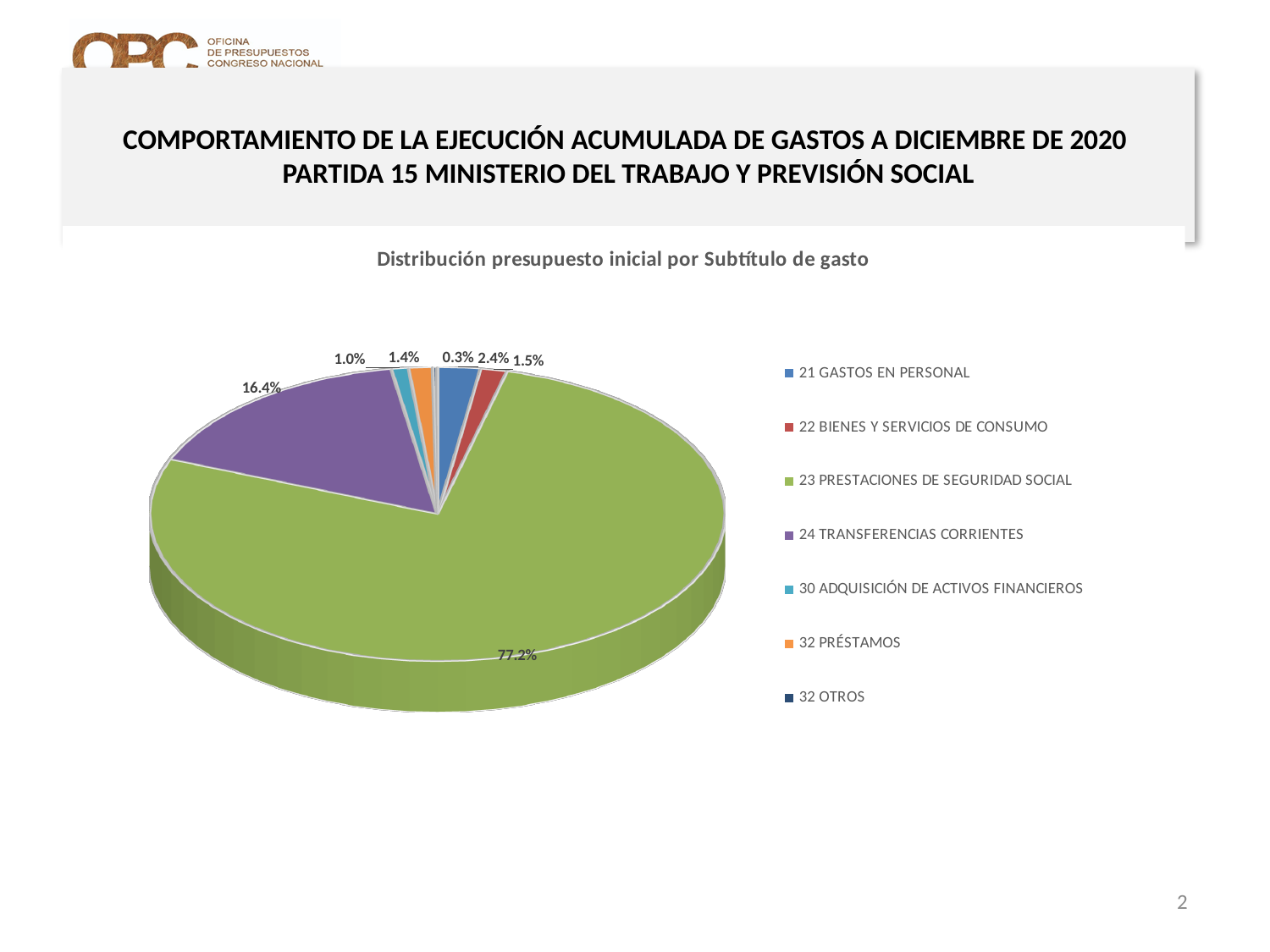
What share of the pie does 24 TRANSFERENCIAS CORRIENTES represent? 16.4% Which category has the largest share of the pie? 23 PRESTACIONES DE SEGURIDAD SOCIAL What share of the pie does 22 BIENES Y SERVICIOS DE CONSUMO represent? 1.5% Which has a larger share, 21 GASTOS EN PERSONAL or 22 BIENES Y SERVICIOS DE CONSUMO? 21 GASTOS EN PERSONAL Which category has the smallest share of the pie? 32 OTROS How many categories does the legend list? 7 What type of chart is shown on the slide? Pie chart What is the difference in percentage points between the shares of 23 PRESTACIONES DE SEGURIDAD SOCIAL and 24 TRANSFERENCIAS CORRIENTES? 60.8 Which legend entry is shown in green? 23 PRESTACIONES DE SEGURIDAD SOCIAL What is the title of the chart? Distribución presupuesto inicial por Subtítulo de gasto What share of the pie does 23 PRESTACIONES DE SEGURIDAD SOCIAL represent? 77.2%